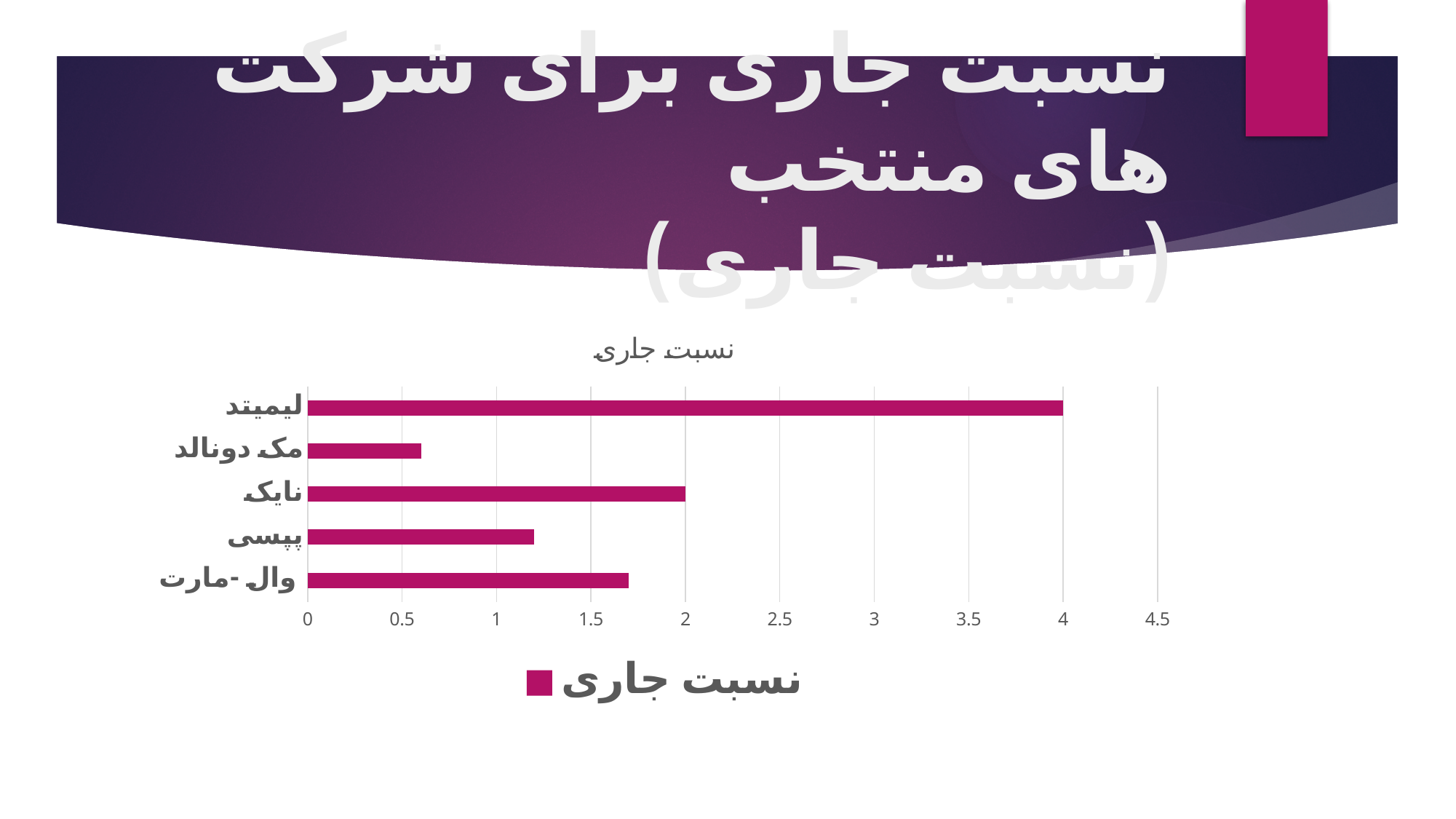
What is the current ratio value for نایک? 2 Which company has the lowest current ratio (نسبت جاری) in the chart? مک دونالد How many companies are shown in the chart? 5 How many series does the legend list? 1 Which company has the highest current ratio (نسبت جاری) in the chart? لیمیتد Which is larger, the value for نایک or the value for پپسی? نایک Is the value for وال-مارت greater or less than 1.5? greater Is the value for مک دونالد greater or less than 1? less What is the title of the chart? نسبت جاری What kind of chart is shown on the slide? bar chart Is the value for پپسی greater or less than 1? greater What is the current ratio value for لیمیتد? 4